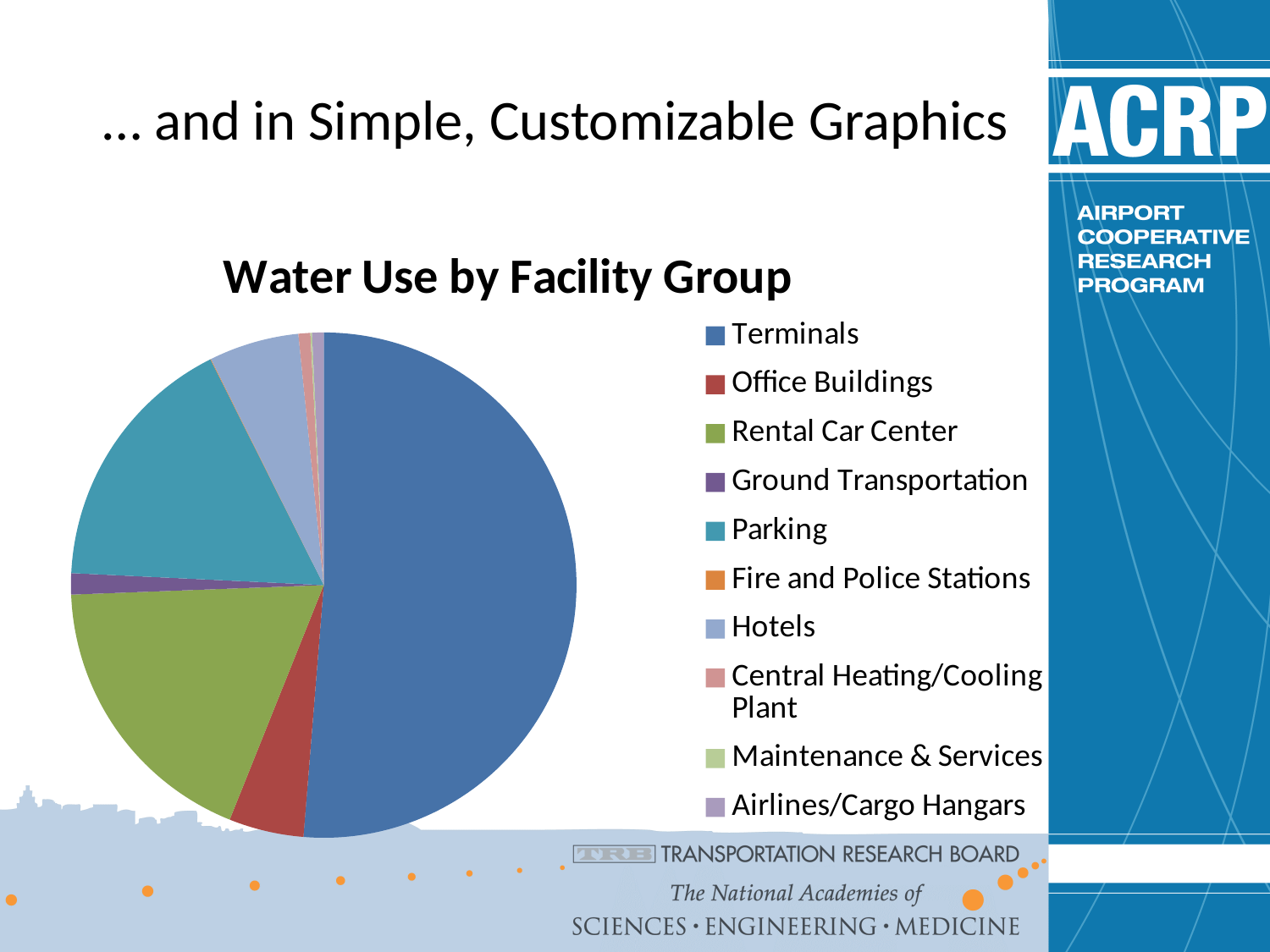
Which uses more water, Rental Car Center or Office Buildings? Rental Car Center What kind of chart is shown on the slide? pie chart How many facility groups does the legend list? 10 What is the title of the chart? Water Use by Facility Group Which uses more water, Parking or Hotels? Parking Which uses more water, Terminals or Rental Car Center? Terminals Which facility group has the largest share of water use? Terminals What colour is the Terminals slice in the pie chart? blue